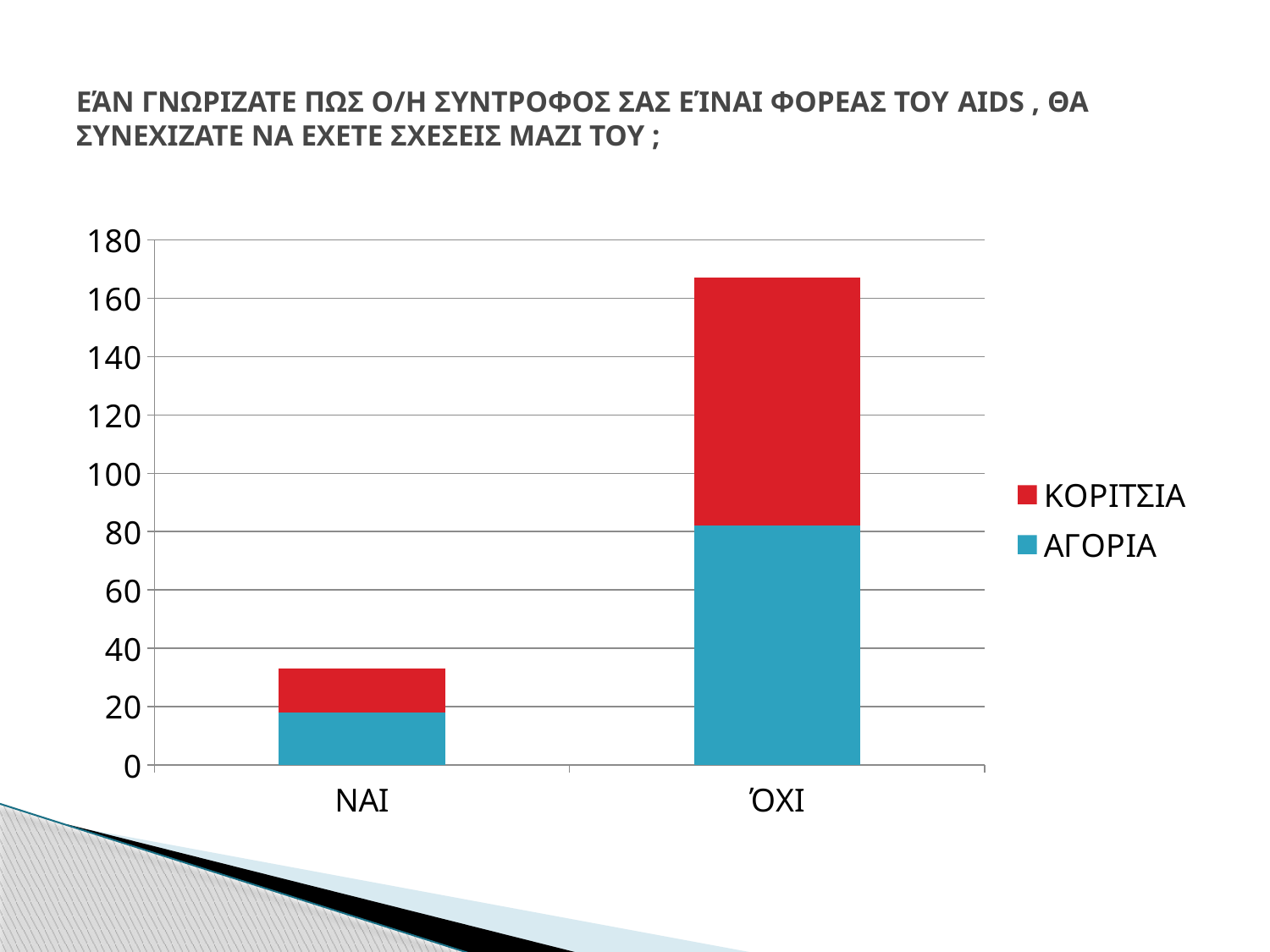
How many categories are shown on the x axis? 2 Which series is shown in red in the legend? ΚΟΡΙΤΣΙΑ What kind of chart is shown on the slide? stacked bar chart What is the highest value shown on the y axis? 180 Is the total value for ΌΧΙ greater or less than 160? greater Which category has the lowest total? ΝΑΙ Which category has the taller stacked bar, ΝΑΙ or ΌΧΙ? ΌΧΙ How many series does the legend list? 2 Is the total value for ΝΑΙ greater or less than 40? less